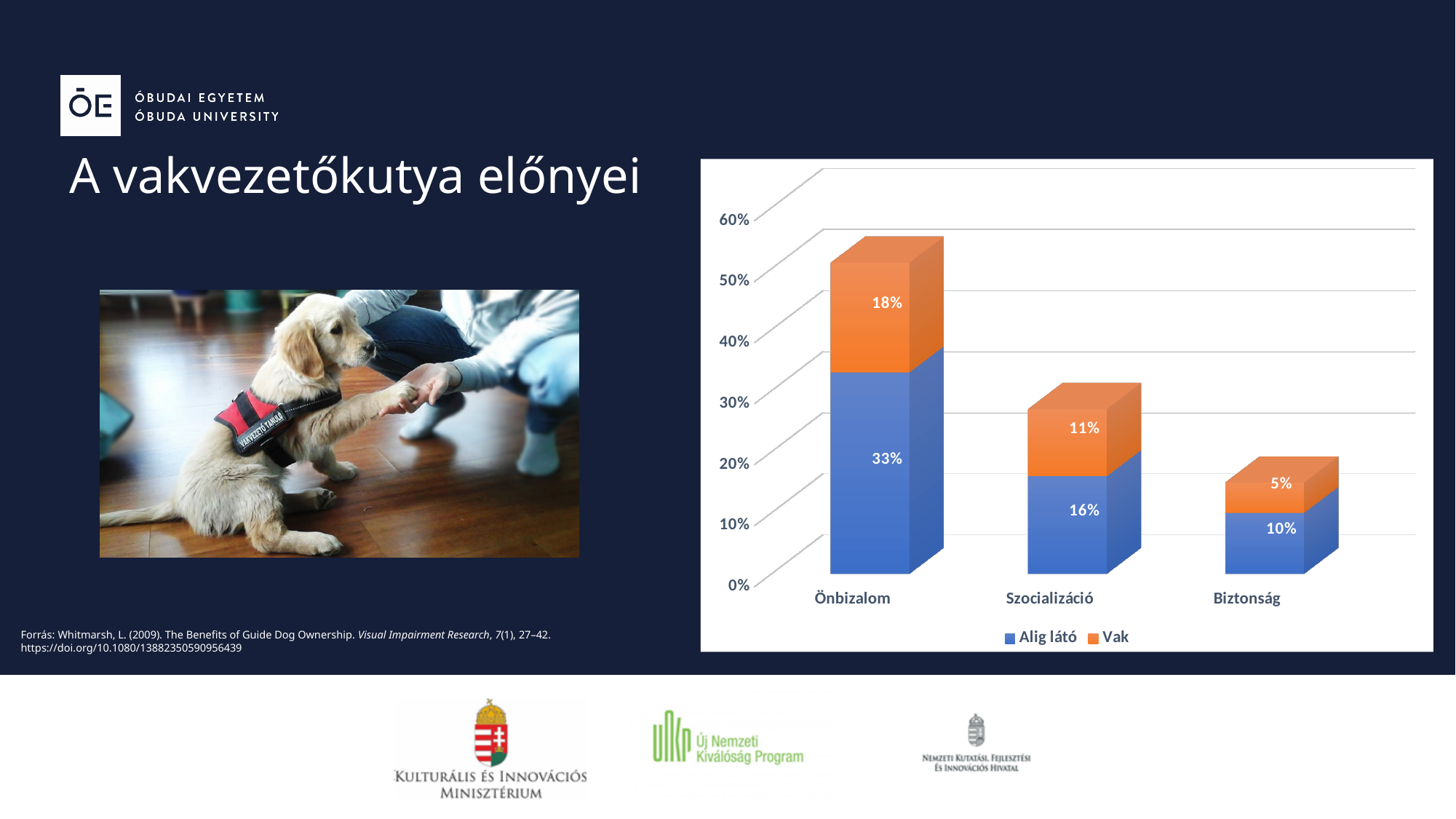
Which is larger: the Vak value for Szocializáció or the Alig látó value for Biztonság? Vak value for Szocializáció How many categories are shown on the x axis? 3 What is the value for Alig látó in the Önbizalom category? 33% What is the value for Vak in the Szocializáció category? 11% What is the total of the stacked bar for Biztonság? 15% What is the total of the stacked bar for Önbizalom? 51% How many series does the legend list? 2 What kind of chart is shown on the slide? Stacked bar chart Which category has the lowest Vak value? Biztonság Which category has the highest Alig látó value? Önbizalom What is the value for Vak in the Biztonság category? 5% What is the difference between the Alig látó values for Önbizalom and Szocializáció? 17%